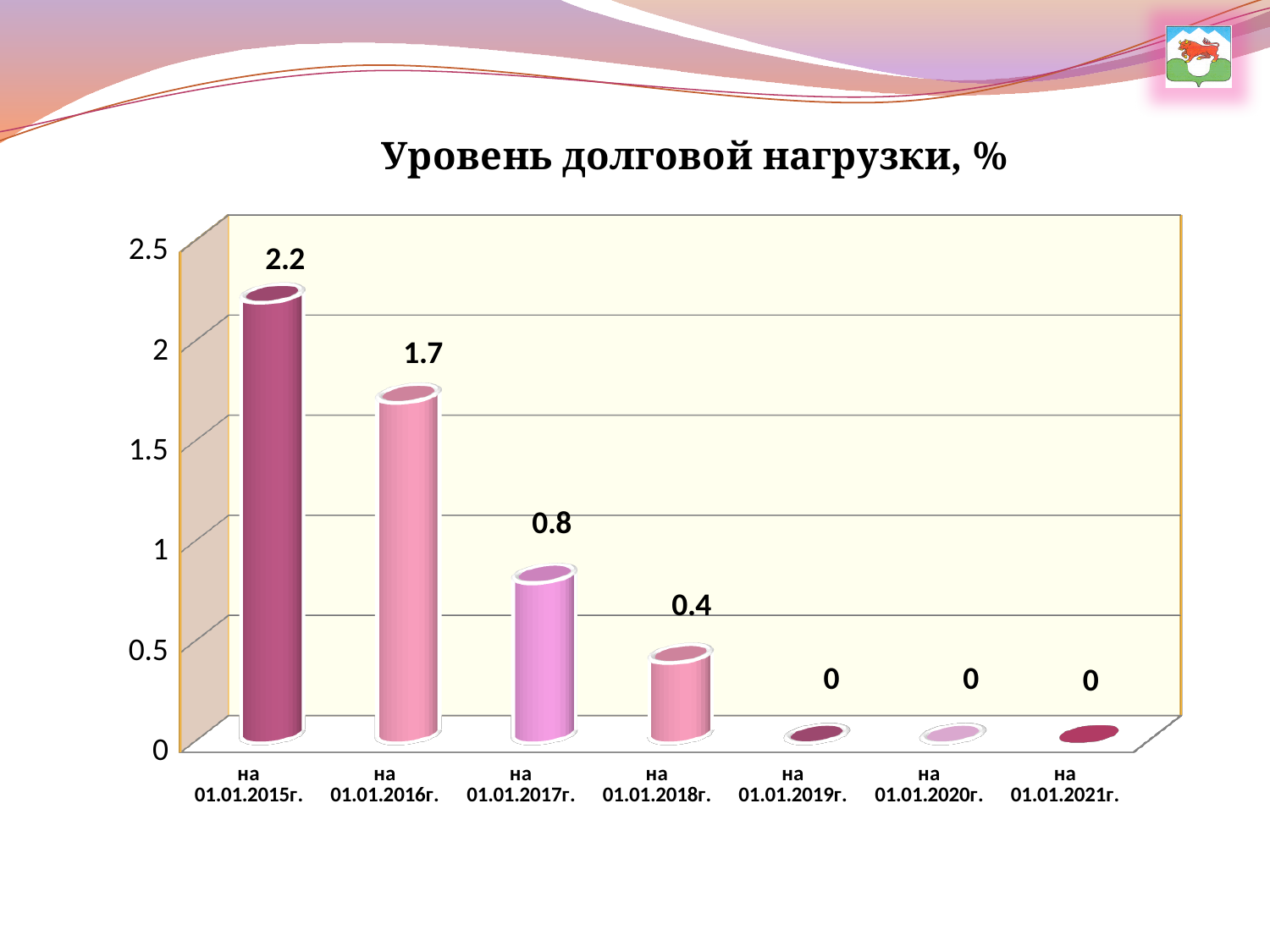
What is the difference between the values for на 01.01.2016г. and на 01.01.2018г.? 1.3 How many categories are shown on the x axis? 7 Which category has the highest value? на 01.01.2015г. What kind of chart is shown on the slide? bar chart Is the value for на 01.01.2015г. greater or less than 2? greater What is the value for на 01.01.2015г.? 2.2 Which is larger, the value for на 01.01.2016г. or на 01.01.2017г.? на 01.01.2016г. Do the values rise or fall from left to right along the x axis? fall What is the value for на 01.01.2017г.? 0.8 What is the value for на 01.01.2018г.? 0.4 What is the value for на 01.01.2020г.? 0 What is the difference between the values for на 01.01.2015г. and на 01.01.2016г.? 0.5